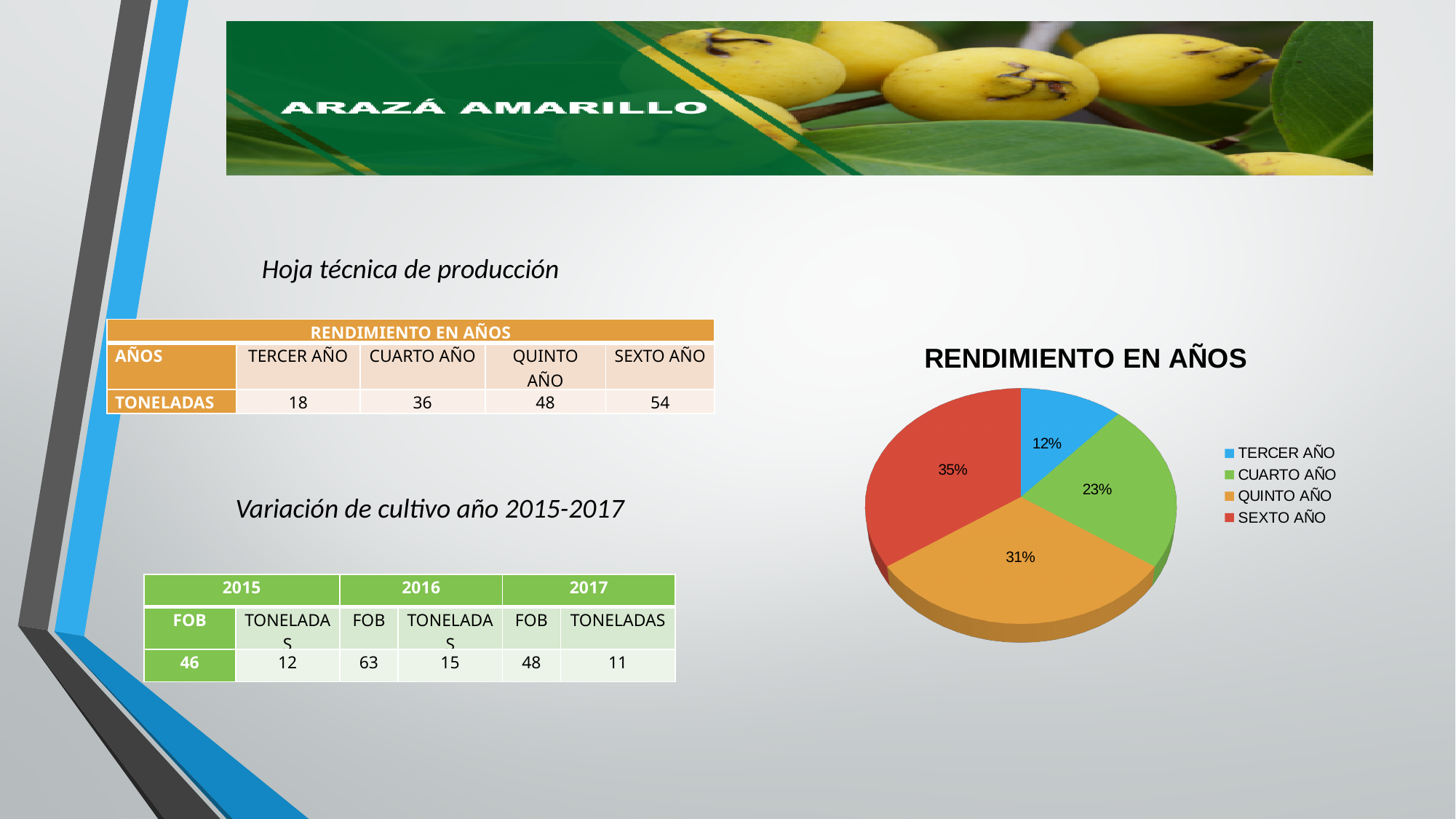
Which slice is larger, CUARTO AÑO or QUINTO AÑO? QUINTO AÑO How many slices does the pie chart have? 4 What is the title of the pie chart? RENDIMIENTO EN AÑOS What kind of chart is shown on the slide? pie chart What is the difference in percentage points between the SEXTO AÑO and TERCER AÑO slices? 23% What share of the pie does SEXTO AÑO represent? 35% Which category has the smallest slice of the pie? TERCER AÑO What share of the pie does TERCER AÑO represent? 12% What share of the pie does CUARTO AÑO represent? 23% How many entries does the legend list? 4 Which category has the largest slice of the pie? SEXTO AÑO